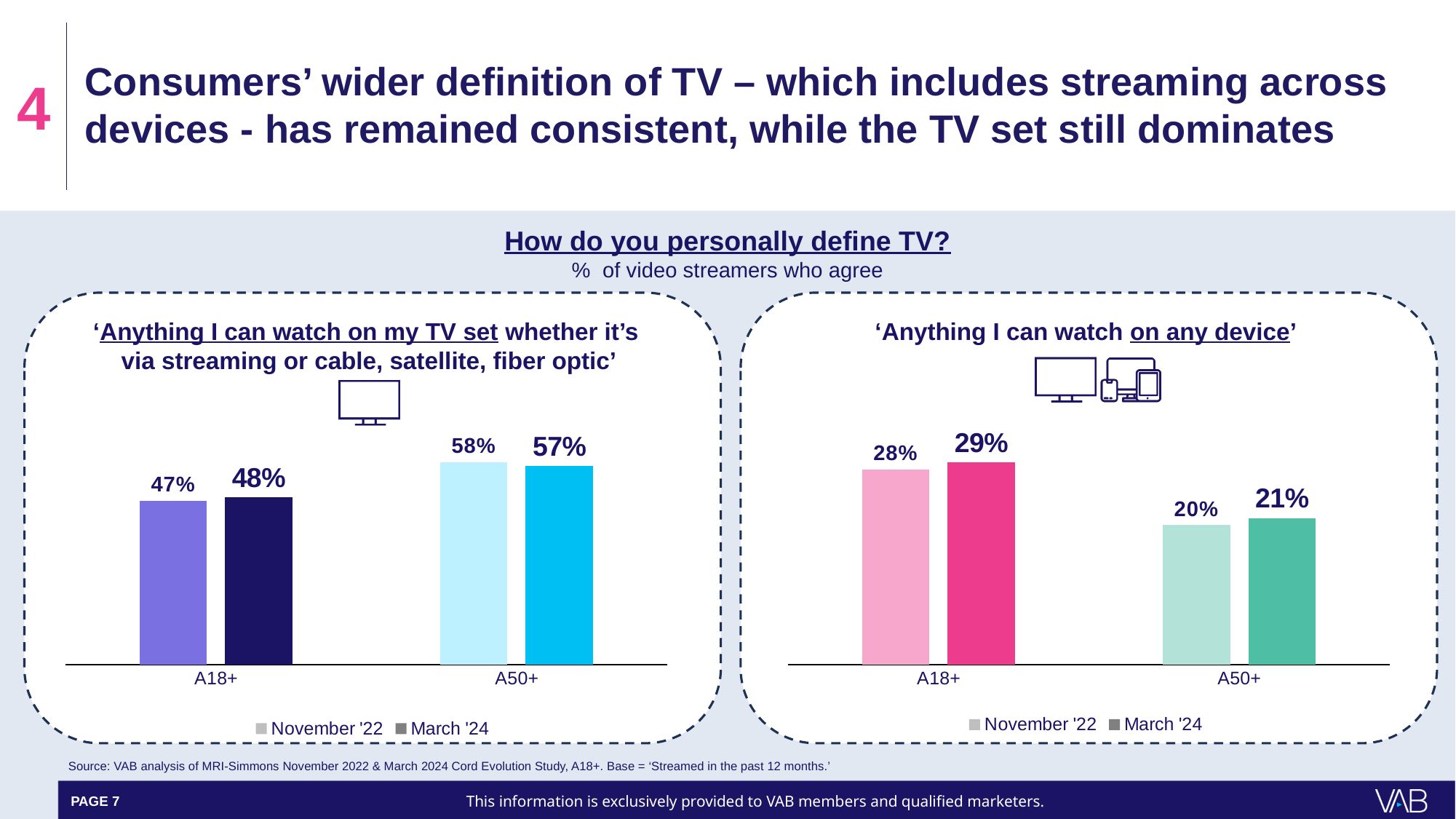
What kind of chart is the right chart ('Anything I can watch on any device')? Bar chart In the right chart ('Anything I can watch on any device'), what is the November '22 value for A50+? 20% In the left chart ('Anything I can watch on my TV set'), what is the March '24 value for A18+? 48% In the right chart ('Anything I can watch on any device'), what is the March '24 value for A18+? 29% In the left chart ('Anything I can watch on my TV set'), which age group has the higher March '24 value? A50+ In the left chart ('Anything I can watch on my TV set'), what is the November '22 value for A50+? 58% In the right chart ('Anything I can watch on any device'), which age group has the lower November '22 value? A50+ In the left chart ('Anything I can watch on my TV set'), what is the difference between the November '22 and March '24 values for A50+? 1% In the right chart ('Anything I can watch on any device'), what is the difference between the A18+ and A50+ March '24 values? 8% What are the two legend entries in the right chart? November '22 and March '24 How many age-group categories are shown on the x axis of the right chart? 2 How many series does the legend of the left chart list? 2